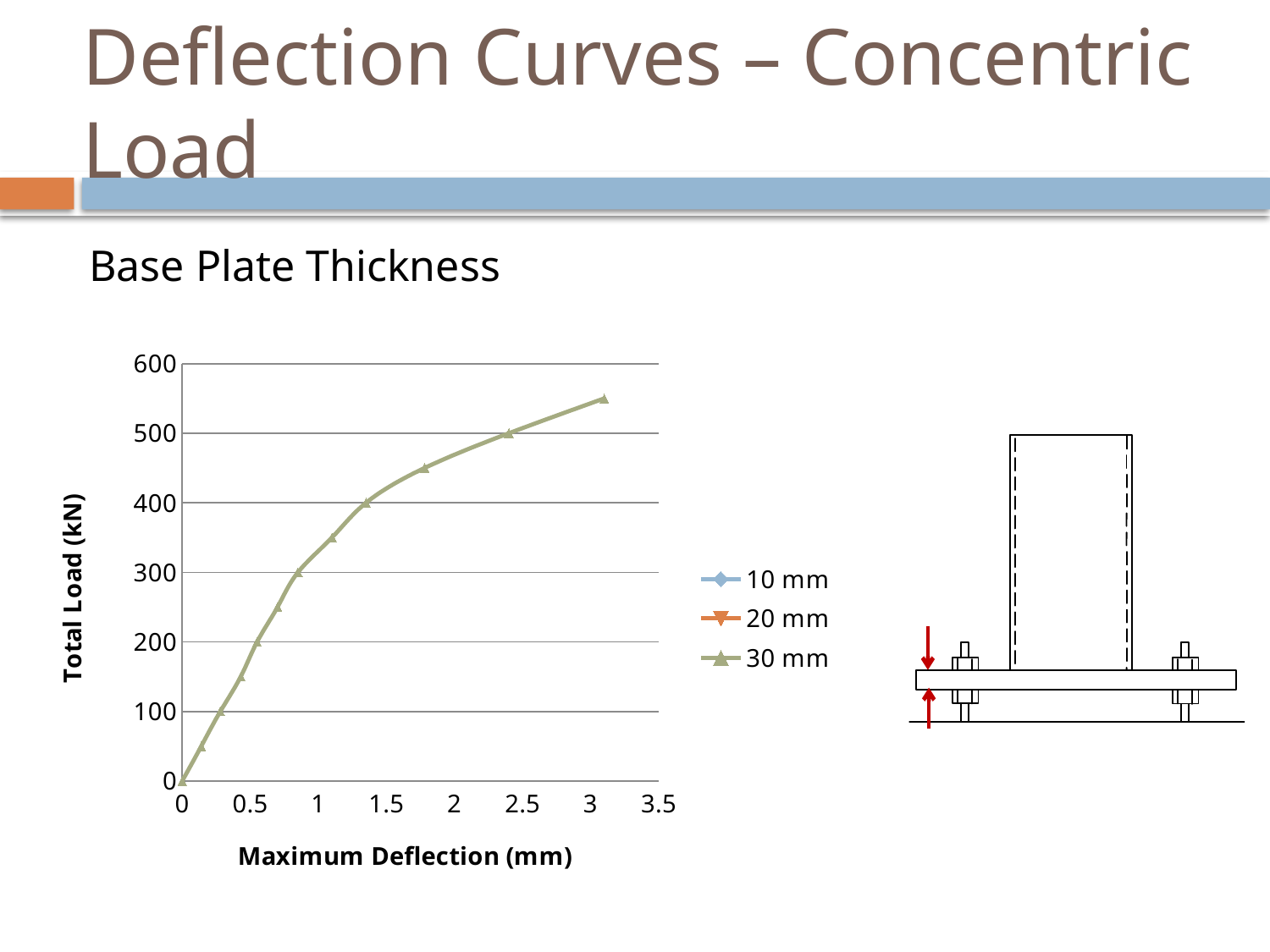
How many series does the chart legend list? 3 What is the title of the x axis of the chart? Maximum Deflection (mm) Which series from the legend is actually plotted as a curve on the chart? 30 mm How many data points are plotted on the 30 mm curve? 12 At a maximum deflection of 2 mm, is the total load on the 30 mm curve greater or less than 400? greater What kind of chart is shown on the slide? line chart Does the total load for the 30 mm series rise or fall as maximum deflection increases? rise Is the highest total load reached by the 30 mm curve greater or less than 500? greater At a maximum deflection of 0.5 mm, is the total load on the 30 mm curve greater or less than 300? less